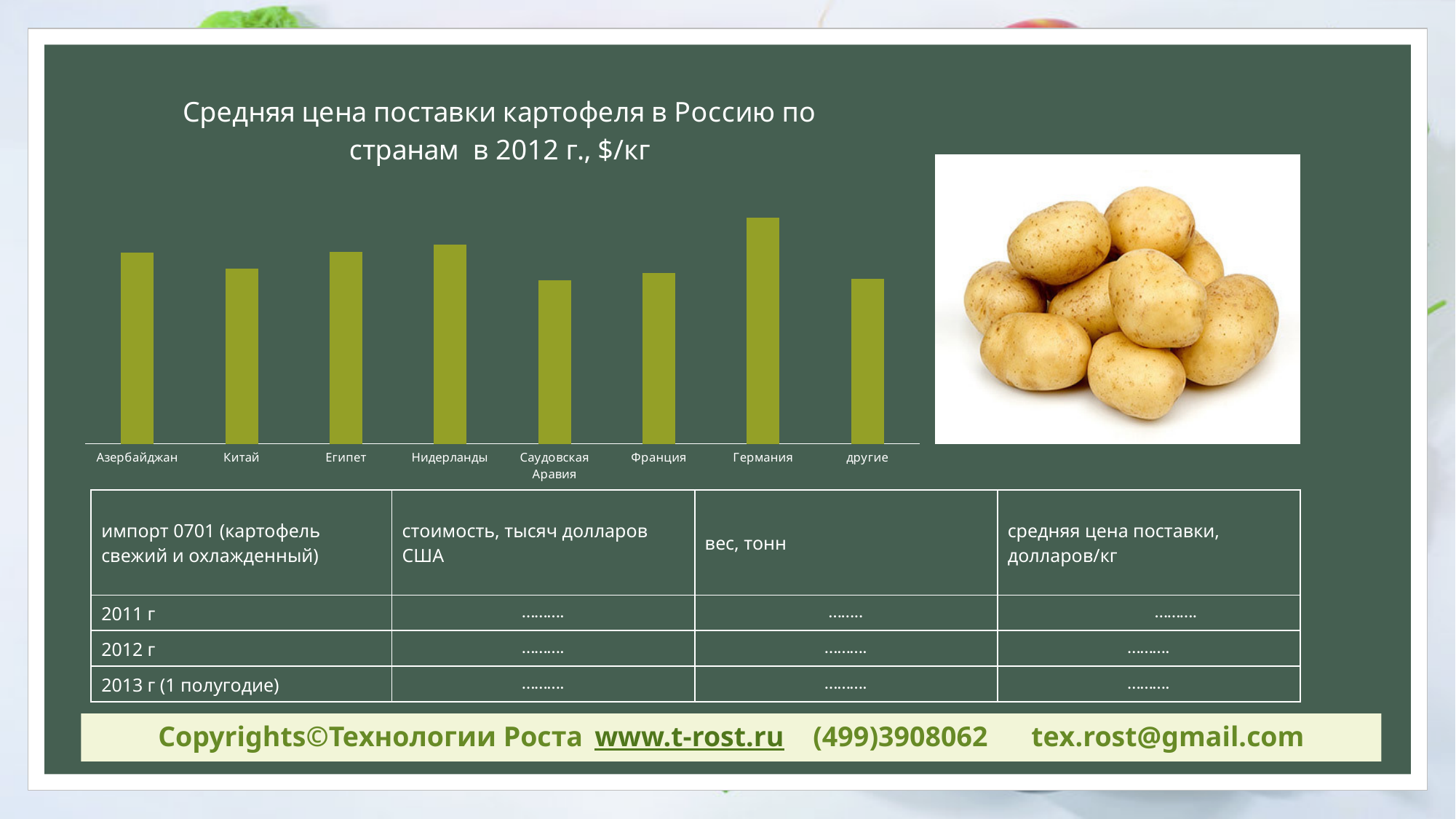
Which is higher in the chart: the bar for Нидерланды or the bar for Китай? Нидерланды What kind of chart is shown on the slide? bar chart Which is higher in the chart: the bar for Египет or the bar for другие? Египет Which category has the highest average potato supply price in the chart? Германия Which is higher in the chart: the bar for Нидерланды or the bar for Саудовская Аравия? Нидерланды How many countries/categories are shown on the x axis of the chart? 8 What is the title of the chart? Средняя цена поставки картофеля в Россию по странам в 2012 г., $/кг What is the first category listed on the x axis of the chart? Азербайджан